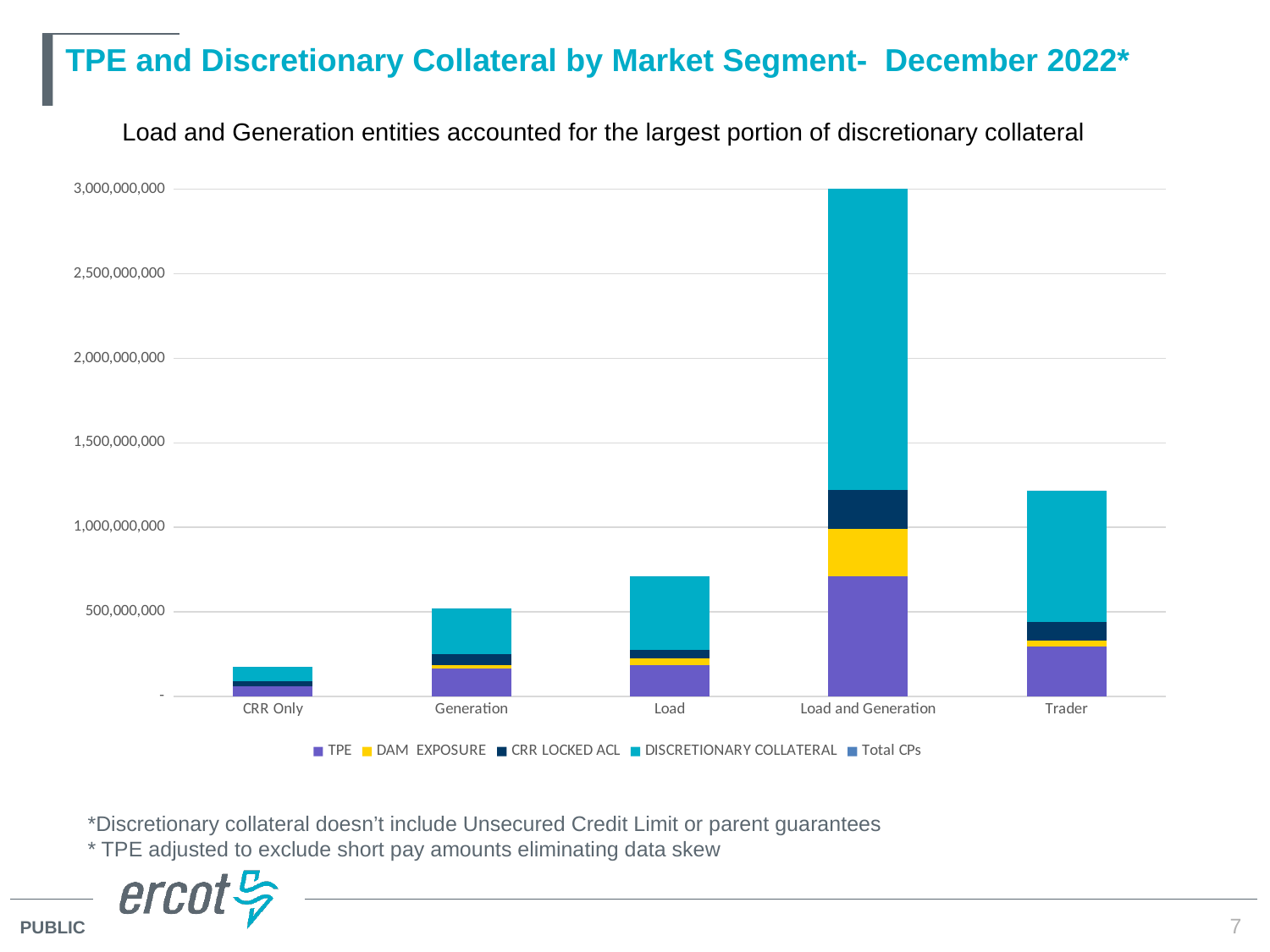
Which market segment has the shortest stacked bar? CRR Only What is the title of the chart slide? TPE and Discretionary Collateral by Market Segment- December 2022* Is the total stacked bar for Load and Generation greater or less than 2,500,000,000? greater How many series does the legend list? 5 Which has the larger total stacked bar, Trader or Load? Trader Is the total stacked bar for CRR Only greater or less than 500,000,000? less Is the total stacked bar for Trader greater or less than 1,000,000,000? greater Which series is shown in yellow in the legend? DAM EXPOSURE What kind of chart is shown on the slide? Stacked bar chart How many market segment categories are shown on the x axis? 5 Which market segment has the tallest stacked bar? Load and Generation